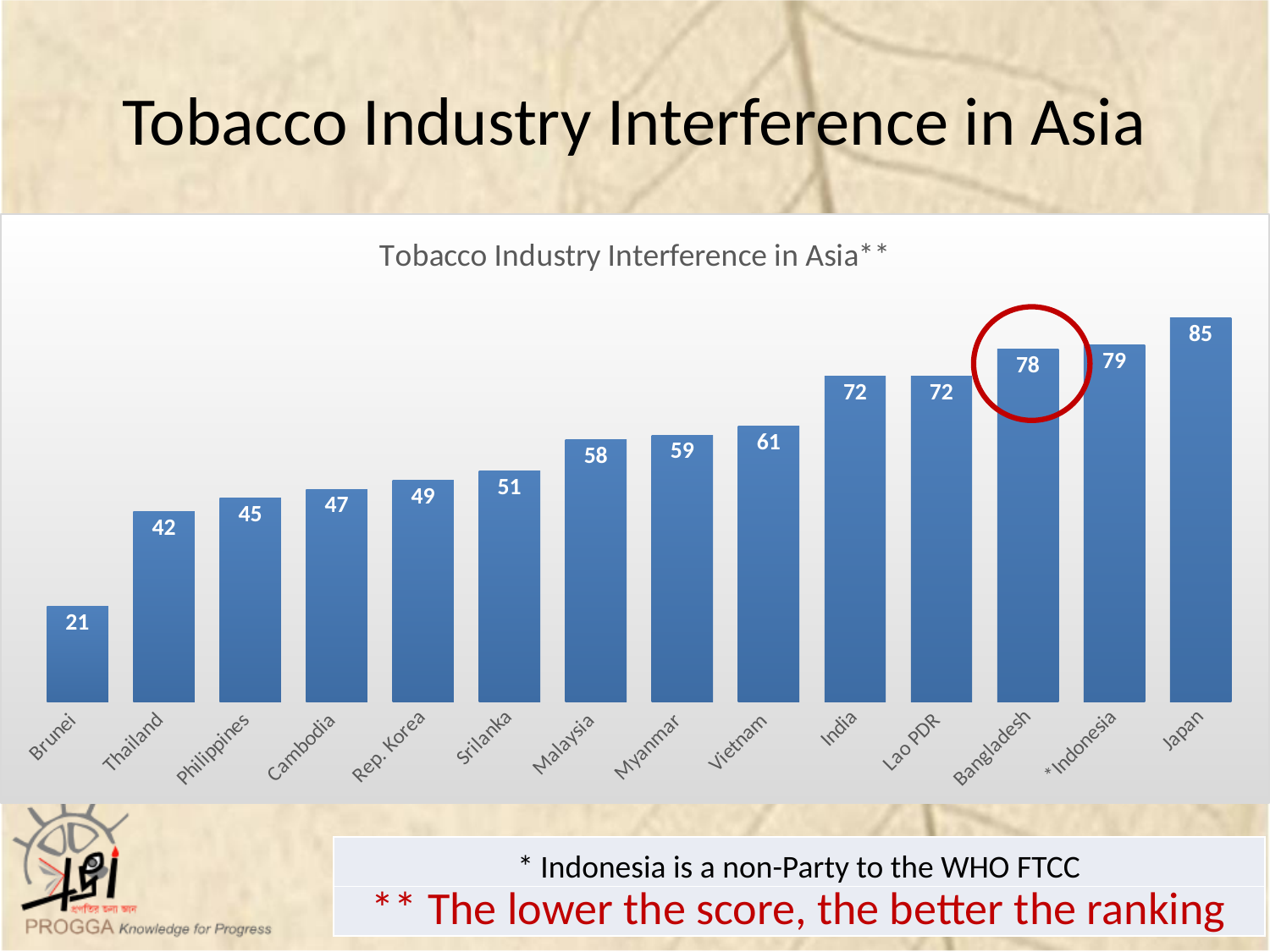
What is the value for Bangladesh? 78 What is the value for Vietnam? 61 Do the values rise or fall from left to right along the x axis? Rise Which country has the lowest value? Brunei What is the value for Brunei? 21 Which country has the highest value? Japan What is the difference between the values for Japan and Bangladesh? 7 How many countries are shown in the chart? 14 What is the difference between the values for Thailand and Brunei? 21 Which is larger, the value for Malaysia or the value for Cambodia? Malaysia Which country's bar is circled in red? Bangladesh What kind of chart is shown? Bar chart